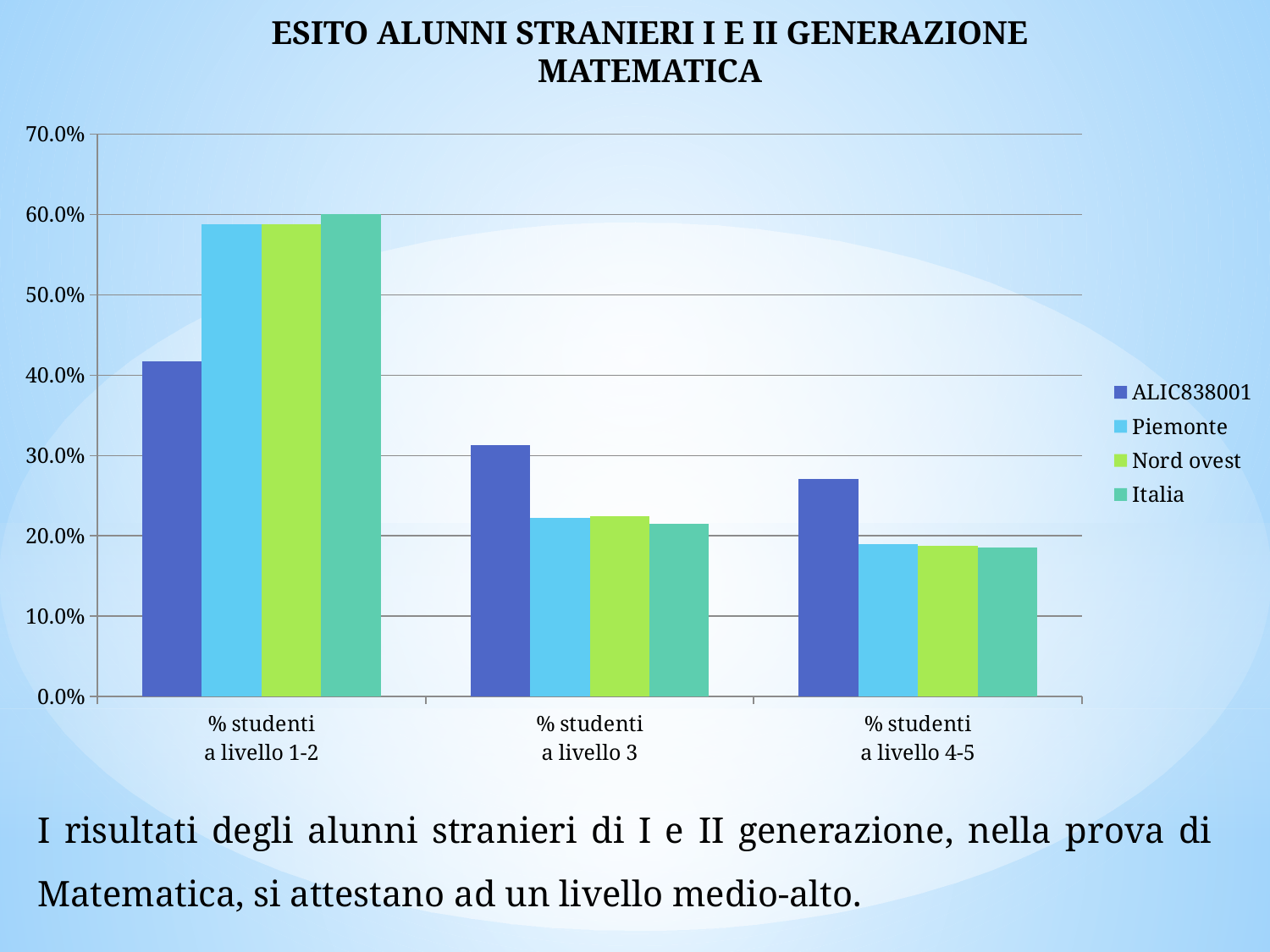
Is the value for ALIC838001 at '% studenti a livello 1-2' greater or less than 50.0%? less Is the value for ALIC838001 at '% studenti a livello 3' greater or less than 30.0%? greater How many series does the legend list? 4 At '% studenti a livello 3', which is larger: ALIC838001 or Italia? ALIC838001 Do the values for ALIC838001 rise or fall from '% studenti a livello 1-2' to '% studenti a livello 4-5'? fall Is the value for Italia at '% studenti a livello 1-2' greater or less than 50.0%? greater Which series has the lowest value at '% studenti a livello 1-2'? ALIC838001 How many categories are shown on the x axis? 3 What kind of chart is shown on the slide? bar chart What is the title of the chart? ESITO ALUNNI STRANIERI I E II GENERAZIONE MATEMATICA Which series has the highest value at '% studenti a livello 4-5'? ALIC838001